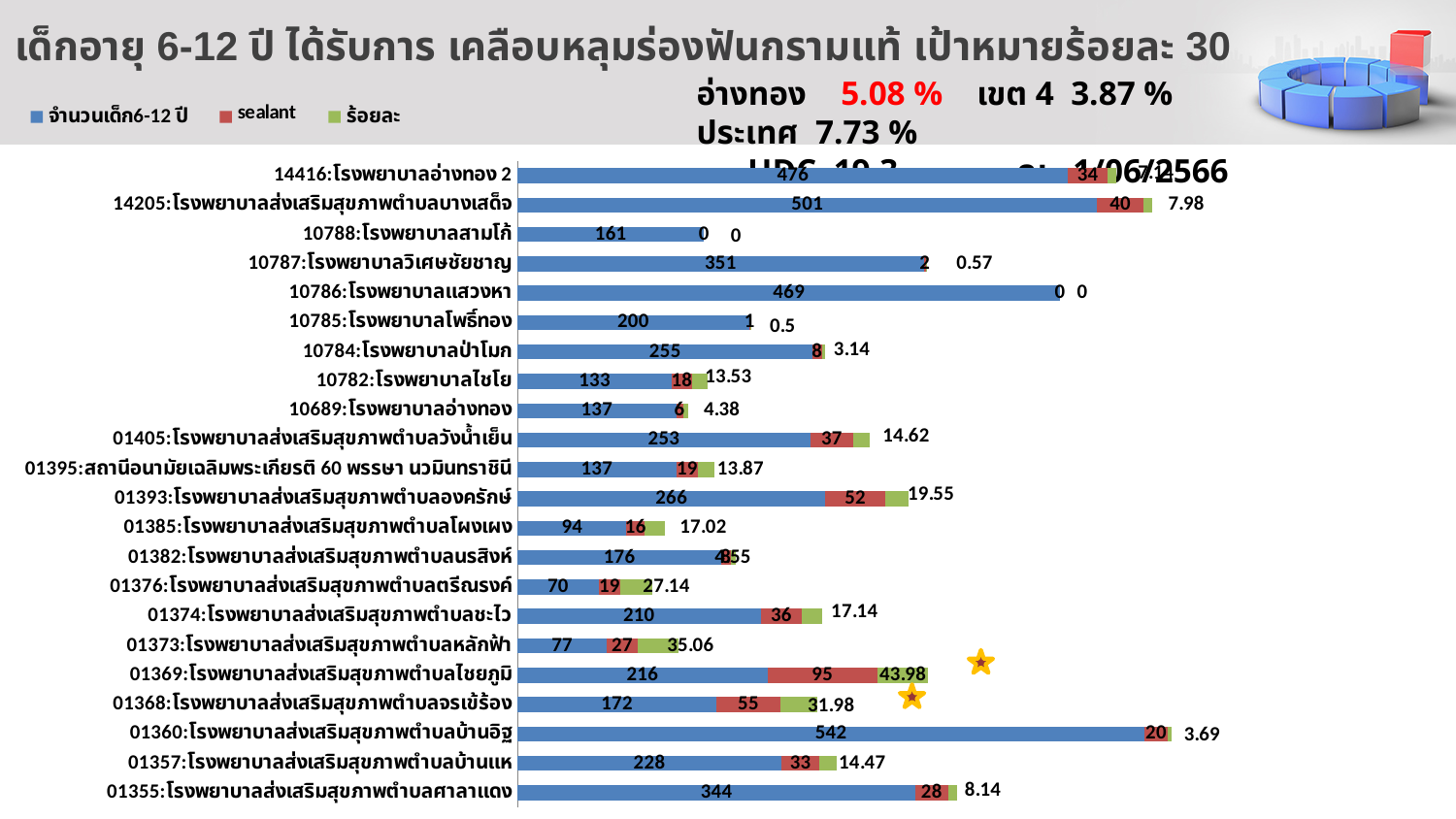
What is the target percentage (เป้าหมายร้อยละ) stated in the chart title? 30 Which has a larger จำนวนเด็ก6-12 ปี value, 14205:โรงพยาบาลส่งเสริมสุขภาพตำบลบางเสด็จ or 10786:โรงพยาบาลแสวงหา? 14205:โรงพยาบาลส่งเสริมสุขภาพตำบลบางเสด็จ What is the sealant value for 01369:โรงพยาบาลส่งเสริมสุขภาพตำบลไชยภูมิ? 95 What kind of chart is shown on the slide? bar chart How many hospital categories are plotted on the chart? 22 Which category has the lowest จำนวนเด็ก6-12 ปี value? 01376:โรงพยาบาลส่งเสริมสุขภาพตำบลตรีณรงค์ What is the difference between the sealant values of 01393:โรงพยาบาลส่งเสริมสุขภาพตำบลองครักษ์ and 01357:โรงพยาบาลส่งเสริมสุขภาพตำบลบ้านแห? 19 What is the จำนวนเด็ก6-12 ปี value for 01360:โรงพยาบาลส่งเสริมสุขภาพตำบลบ้านอิฐ? 542 What is the ร้อยละ value for 01373:โรงพยาบาลส่งเสริมสุขภาพตำบลหลักฟ้า? 35.06 Which category has the highest ร้อยละ value? 01369:โรงพยาบาลส่งเสริมสุขภาพตำบลไชยภูมิ How many series does the chart legend list? 3 Which category has the highest จำนวนเด็ก6-12 ปี value? 01360:โรงพยาบาลส่งเสริมสุขภาพตำบลบ้านอิฐ